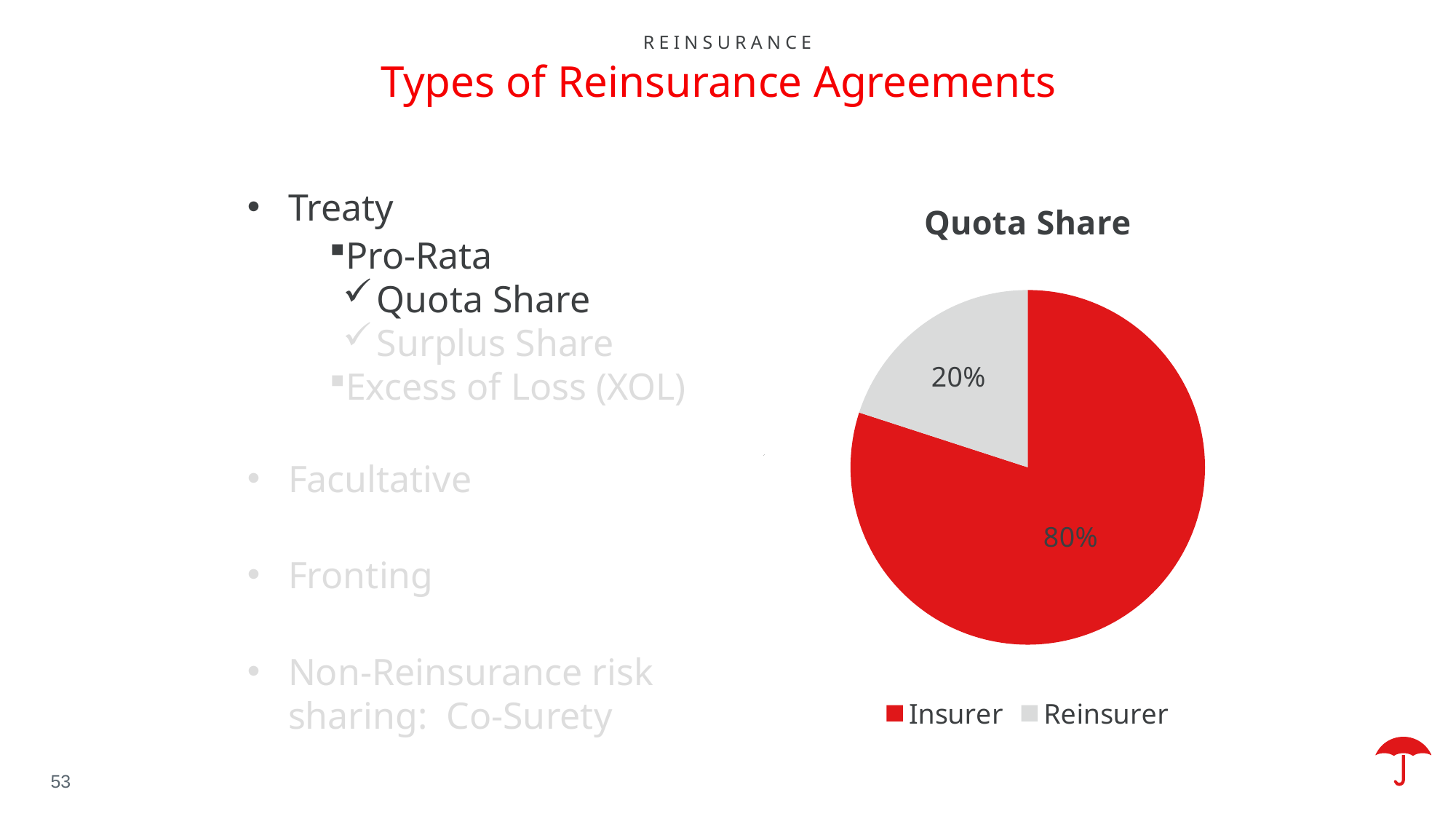
Which is larger, the Insurer slice or the Reinsurer slice? Insurer What share of the pie does the Reinsurer slice represent? 20% What is the title of the pie chart? Quota Share What type of chart is shown on the slide? pie chart What colour is the Reinsurer slice in the pie chart? grey How many entries does the legend of the pie chart list? 2 What is the difference in percentage points between the Insurer and Reinsurer slices? 60 How many slices does the pie chart have? 2 What is the total of the two slices shown in the pie chart? 100% Which slice of the pie chart is the smallest? Reinsurer What share of the pie does the Insurer slice represent? 80% Which slice of the pie chart is the largest? Insurer